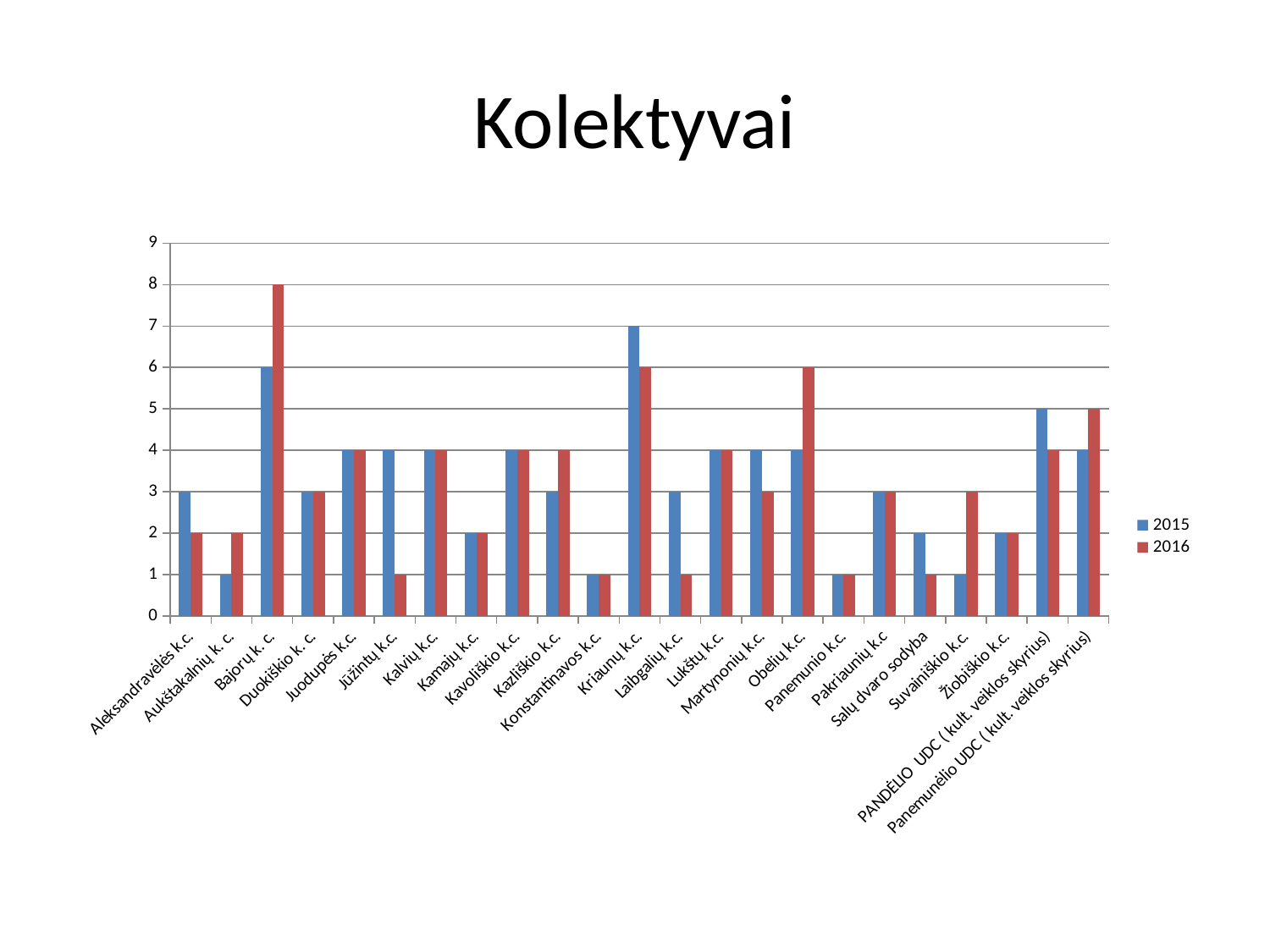
What is the title of the chart? Kolektyvai What type of chart is shown on the slide? Bar chart What is the 2016 value for Bajorų k. c.? 8 Which category has the highest 2016 value? Bajorų k. c. Which colour represents the 2016 series? Red Which category has the highest 2015 value? Kriaunų k.c. How many categories are shown on the x axis? 23 What is the 2015 value for Kriaunų k.c.? 7 How many series does the legend list? 2 What is the 2016 value for Suvainiškio k.c.? 3 What is the difference between the 2016 and 2015 values for Obelių k.c.? 2 For Jūžintų k.c., which year has the larger value, 2015 or 2016? 2015